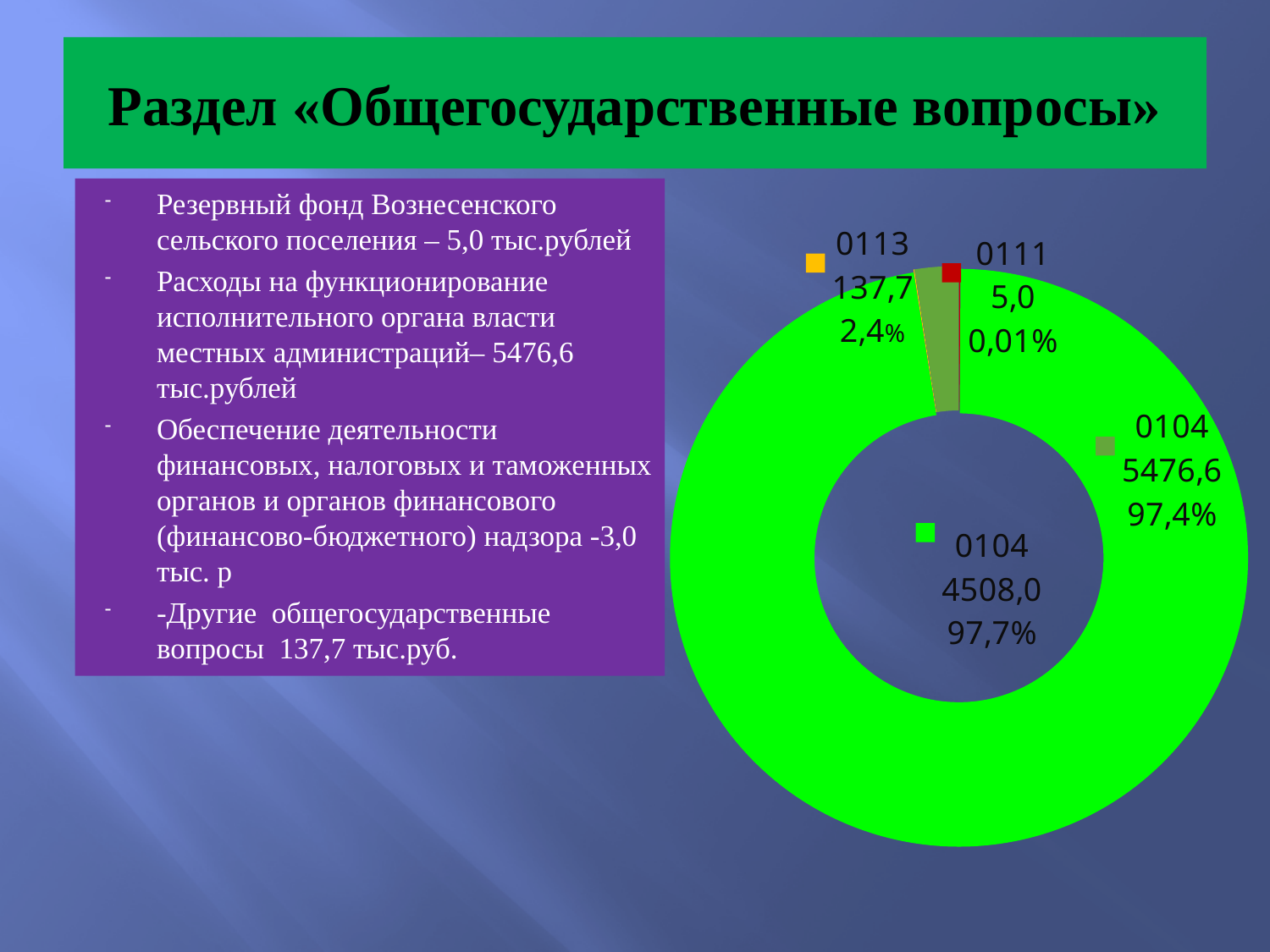
What value is shown on the outer label for category 0104? 5476,6 What is the difference between the value for 0113 (137,7) and the value for 0111 (5,0)? 132,7 What percentage share is shown for category 0111? 0,01% Which is larger, the value for 0113 or the value for 0111? 0113 What percentage share is shown on the outer label for category 0104? 97,4% What value is shown for category 0111 in the chart? 5,0 Which category has the largest slice in the chart? 0104 What colour is the slice for category 0104? green What kind of chart is shown on the slide? doughnut chart What value is shown for category 0113 in the chart? 137,7 What percentage share is shown for category 0113? 2,4%